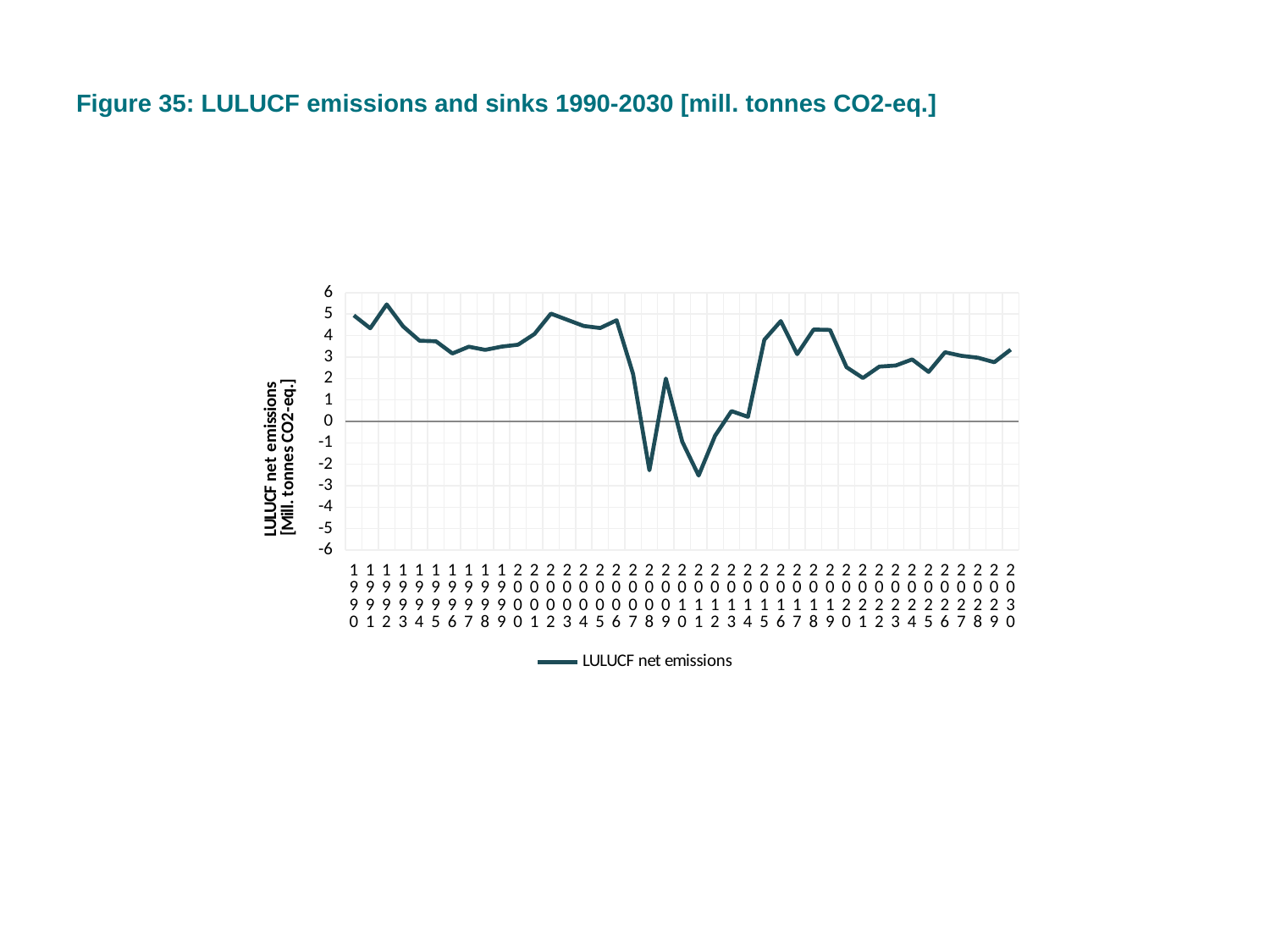
What is the label on the y axis? LULUCF net emissions [Mill. tonnes CO2-eq.] How many years (data points) are plotted along the x axis? 41 Is the value for 2008 greater or less than 0? less Is the value for 1990 greater or less than 4? greater What kind of chart is shown on the slide? Line chart In which year does LULUCF net emissions reach its highest value? 1992 Is the value for 2011 greater or less than -2? less Do the values rise or fall between 2006 and 2008? fall How many series does the legend list? 1 Which year has the larger value, 1992 or 2011? 1992 Which year has the larger value, 2008 or 2009? 2009